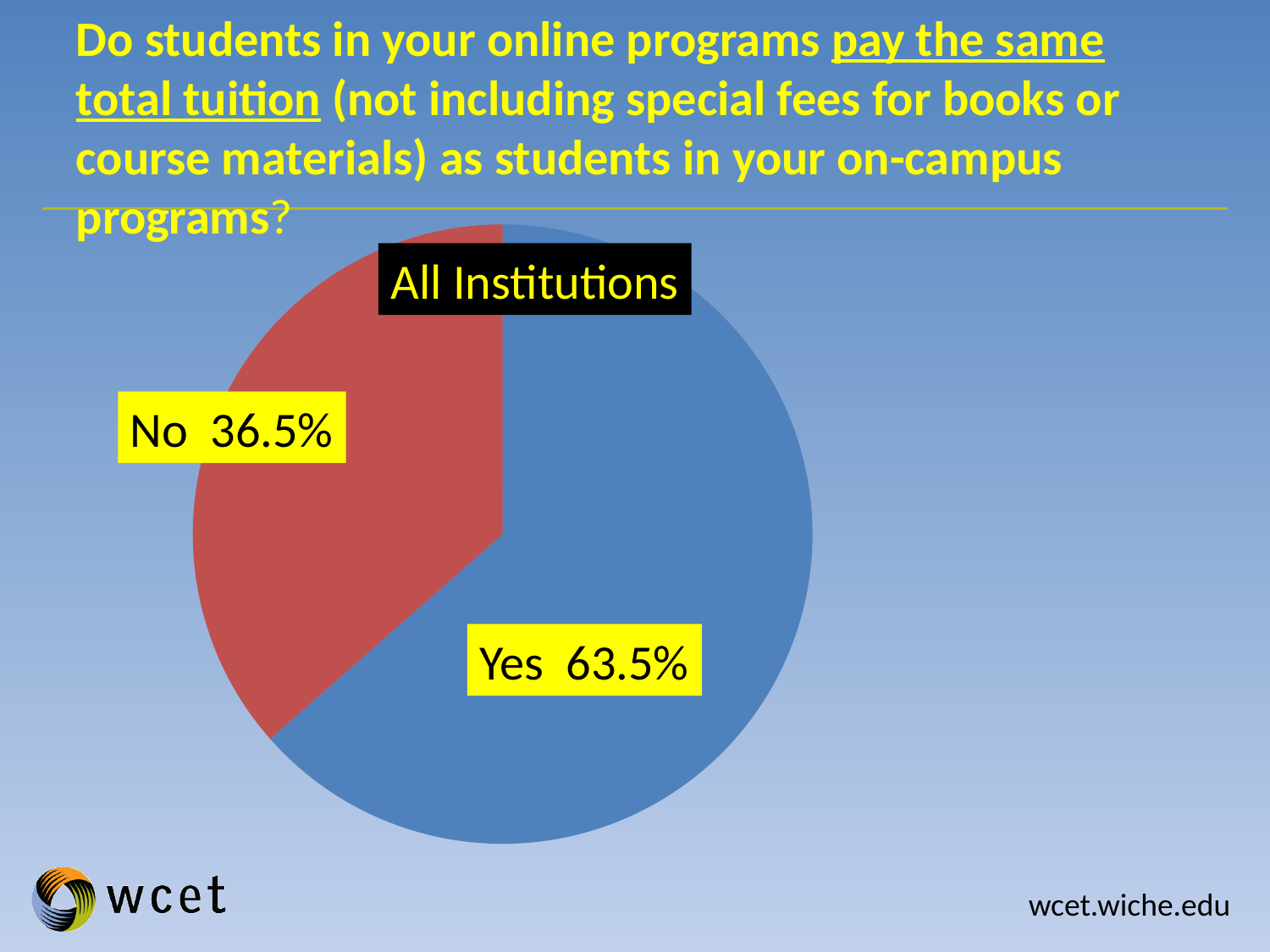
What kind of chart is shown on the slide? pie chart Which response has the smaller share of the pie? No What colour is the Yes slice of the pie chart? blue What percentage of institutions answered Yes? 63.5% What percentage of institutions answered No? 36.5% What is the label shown on the pie chart indicating which group the data covers? All Institutions How many slices does the pie chart have? 2 Which response has the larger share of the pie? Yes What is the difference in percentage points between the Yes and No shares? 27 percentage points What share of the pie does the No slice represent? 36.5% Is the share for Yes larger or smaller than the share for No? larger